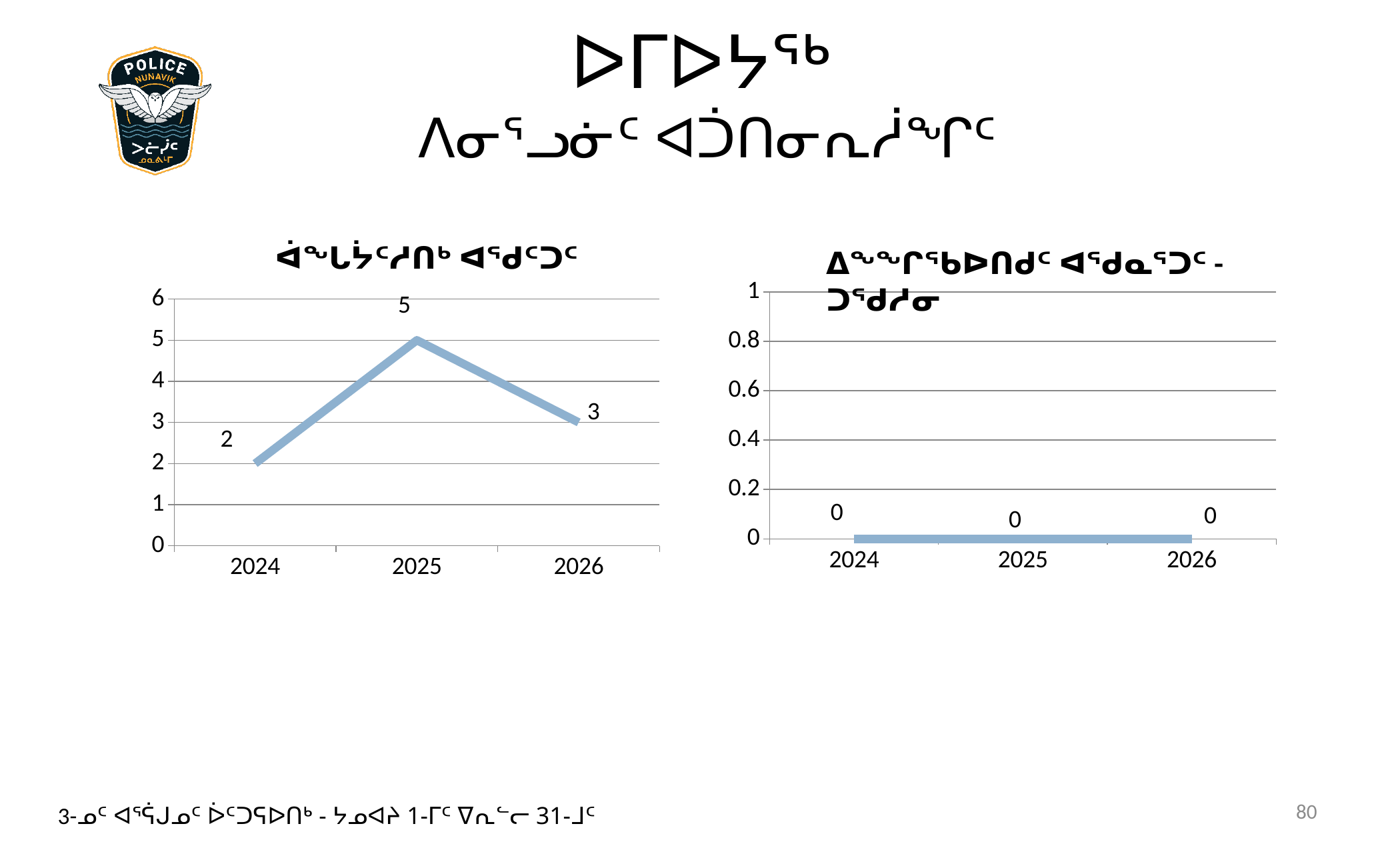
In the left chart, which year has the highest value? 2025 In the left chart, which is larger, the value for 2026 or the value for 2024? 2026 In the left chart, which year has the lowest value? 2024 In the right chart, what is the total of the values for 2024, 2025 and 2026? 0 In the left chart, what is the difference between the values for 2025 and 2024? 3 In the left chart, what is the value for 2024? 2 In the left chart, what is the value for 2026? 3 In the right chart, what is the value for 2025? 0 In the left chart, what is the value for 2025? 5 In the left chart, how many years are plotted? 3 What kind of chart is the left chart? line chart In the right chart, what is the highest value shown on the vertical axis? 1